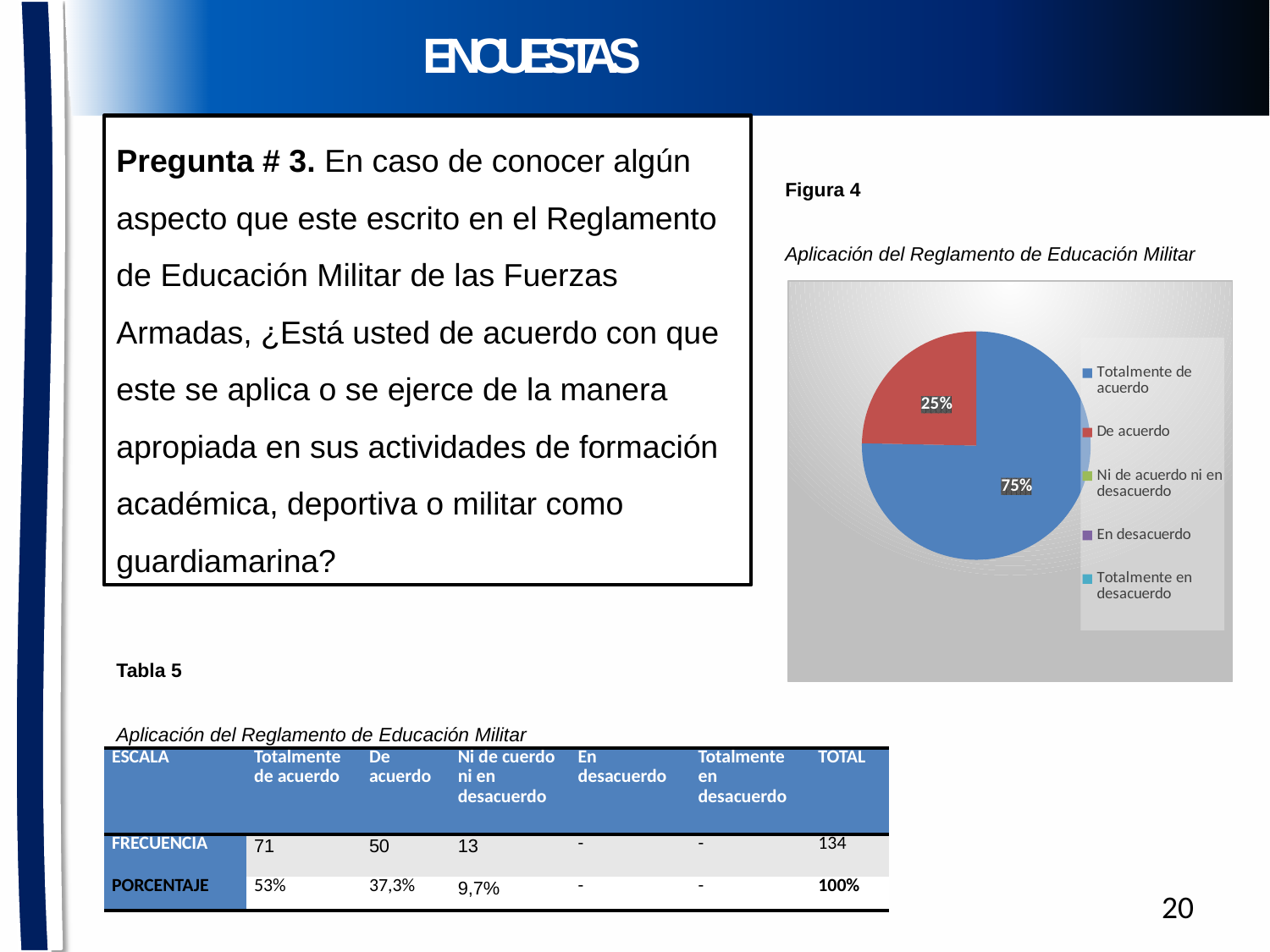
Which of the two labelled slices in the pie chart is smaller, 'Totalmente de acuerdo' or 'De acuerdo'? De acuerdo In the pie chart, what percentage is shown for the 'De acuerdo' slice? 25% What is the difference in percentage points between the 'Totalmente de acuerdo' slice and the 'De acuerdo' slice in the pie chart? 50 What share of the pie does the 'Totalmente de acuerdo' slice represent? 75% What colour is the 'De acuerdo' slice in the pie chart? red How many slices with data labels are visible in the pie chart? 2 In the pie chart, what percentage is shown for the 'Totalmente de acuerdo' slice? 75% What is the title of the chart in Figura 4? Aplicación del Reglamento de Educación Militar How many entries does the legend of the pie chart list? 5 Which category has the largest slice in the pie chart? Totalmente de acuerdo What type of chart is shown in Figura 4? pie chart